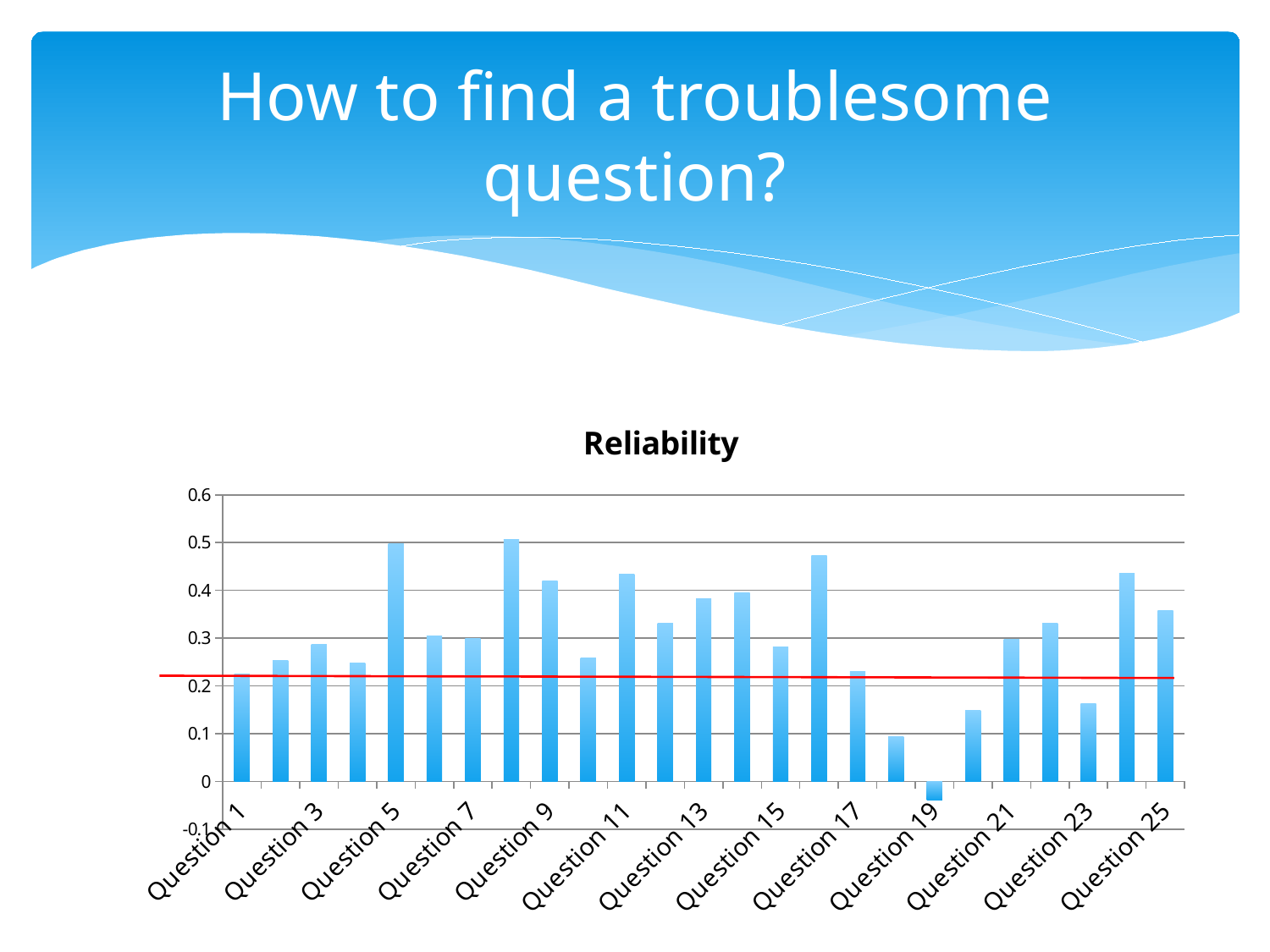
Is the value for Question 19 greater or less than 0? less What type of chart is shown on the slide? bar chart What colour is the horizontal reference line drawn across the chart? red Is the value for Question 20 greater or less than 0.2? less What is the title of the chart? Reliability Which has the larger value, Question 16 or Question 17? Question 16 Is the value for Question 16 greater or less than 0.4? greater How many questions (bars) are plotted in the Reliability chart? 25 Which question has the lowest reliability value? Question 19 Which has the larger value, Question 23 or Question 24? Question 24